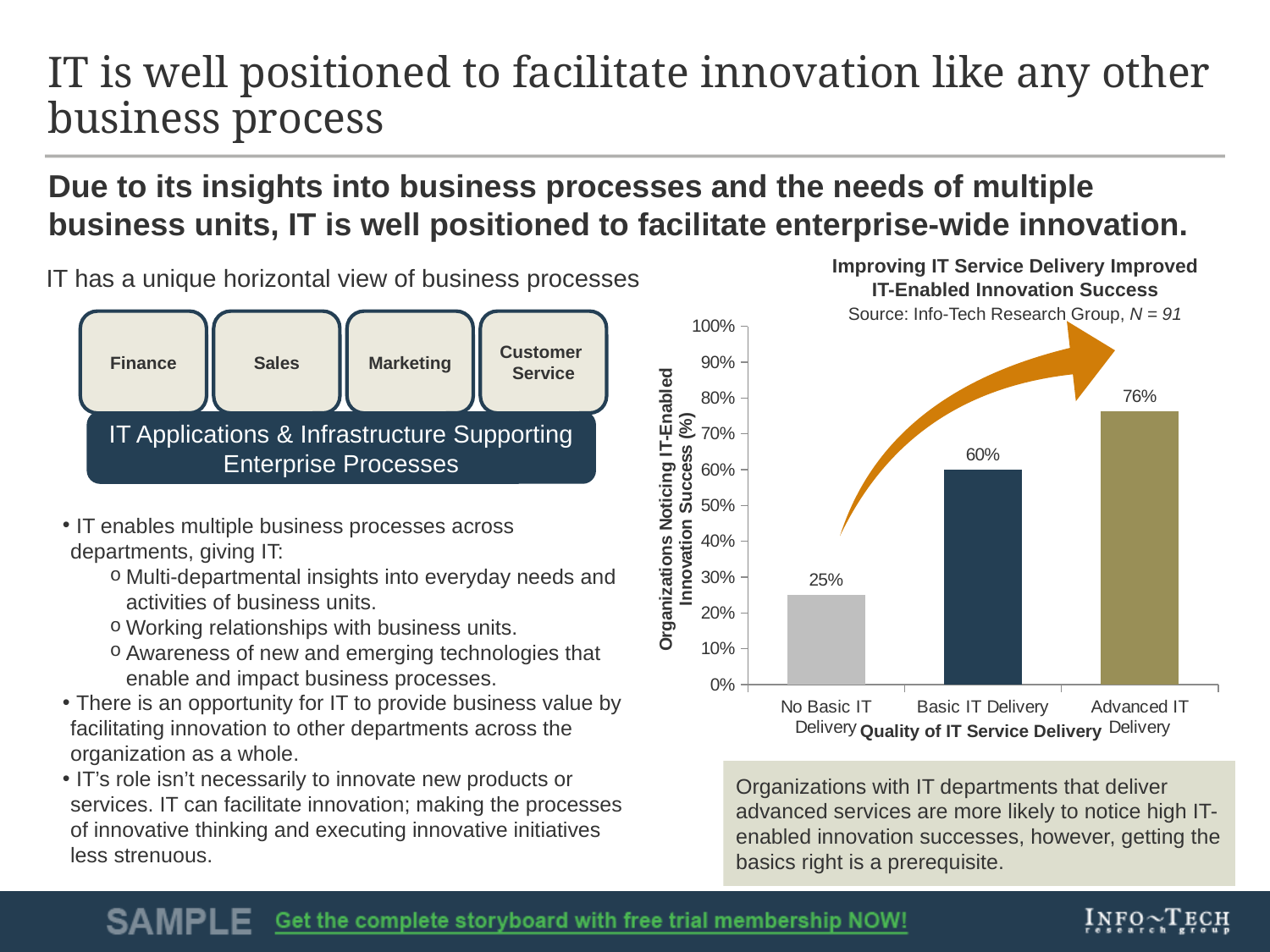
Do the values rise or fall from No Basic IT Delivery to Advanced IT Delivery? Rise How many categories are shown on the x axis of the chart? 3 Which quality of IT service delivery has the highest percentage of organizations noticing innovation success? Advanced IT Delivery What is the value shown for Advanced IT Delivery? 76% What kind of chart is shown on the slide? Bar chart What is the difference between the values for Basic IT Delivery and No Basic IT Delivery? 35% What percentage of organizations noticed IT-enabled innovation success with No Basic IT Delivery? 25% Which is larger, the value for Basic IT Delivery or the value for No Basic IT Delivery? Basic IT Delivery Which quality of IT service delivery has the lowest percentage? No Basic IT Delivery What is the value shown for Basic IT Delivery? 60% What is the difference between the values for Advanced IT Delivery and Basic IT Delivery? 16% Is the value for Advanced IT Delivery greater or less than 70%? greater